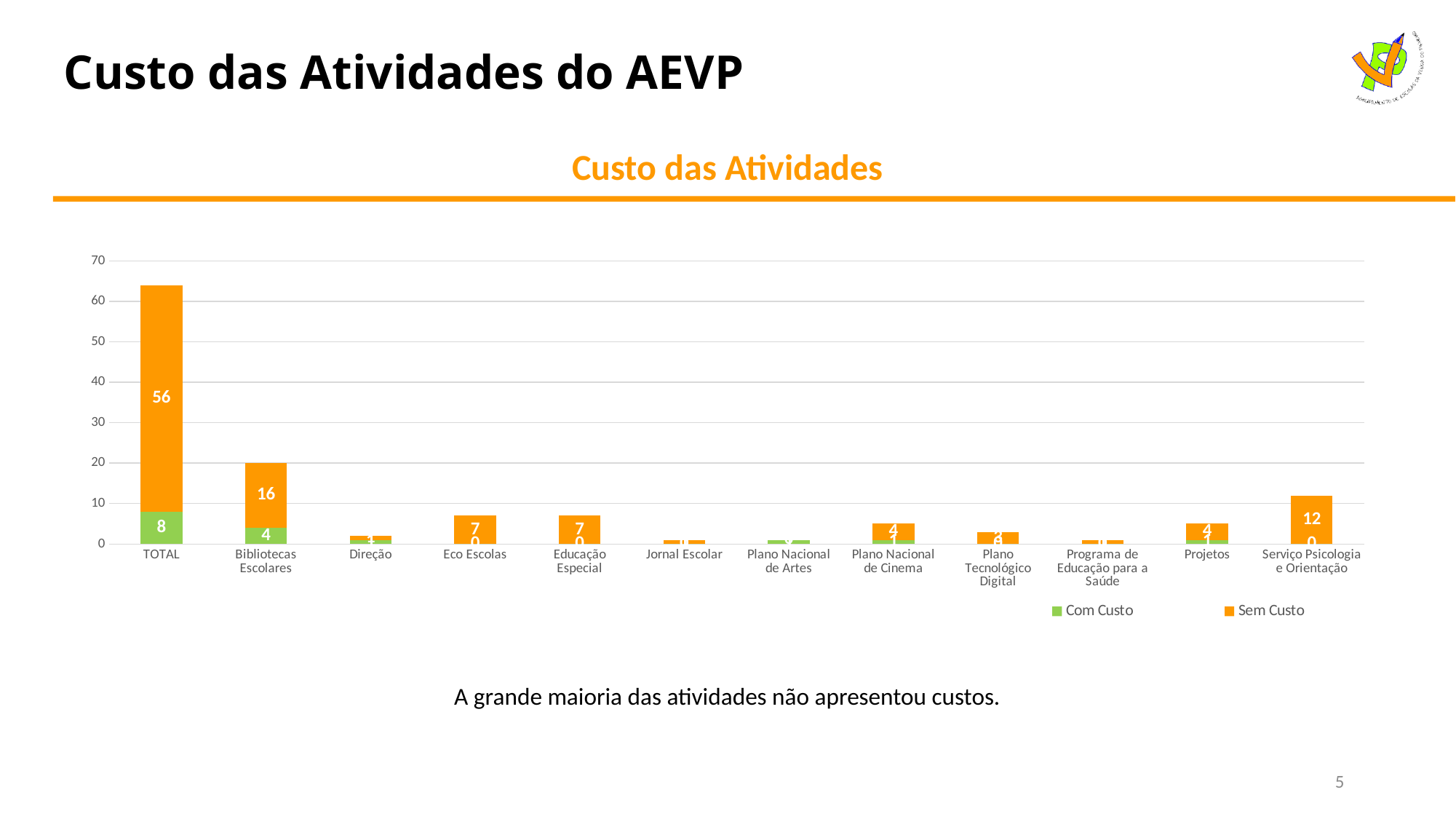
What kind of chart is shown on the slide? Stacked bar chart What is the Sem Custo value for Bibliotecas Escolares? 16 What is the Com Custo value for TOTAL? 8 How many categories are shown on the x axis? 12 What is the Sem Custo value for TOTAL? 56 Which category has the tallest stacked bar? TOTAL What is the Sem Custo value for Serviço Psicologia e Orientação? 12 How many series does the legend list? 2 What is the total height of the stacked bar for TOTAL? 64 What is the difference between the Sem Custo and Com Custo values for TOTAL? 48 Is the total stacked bar for TOTAL greater or less than 60? greater What is the total height of the stacked bar for Bibliotecas Escolares? 20